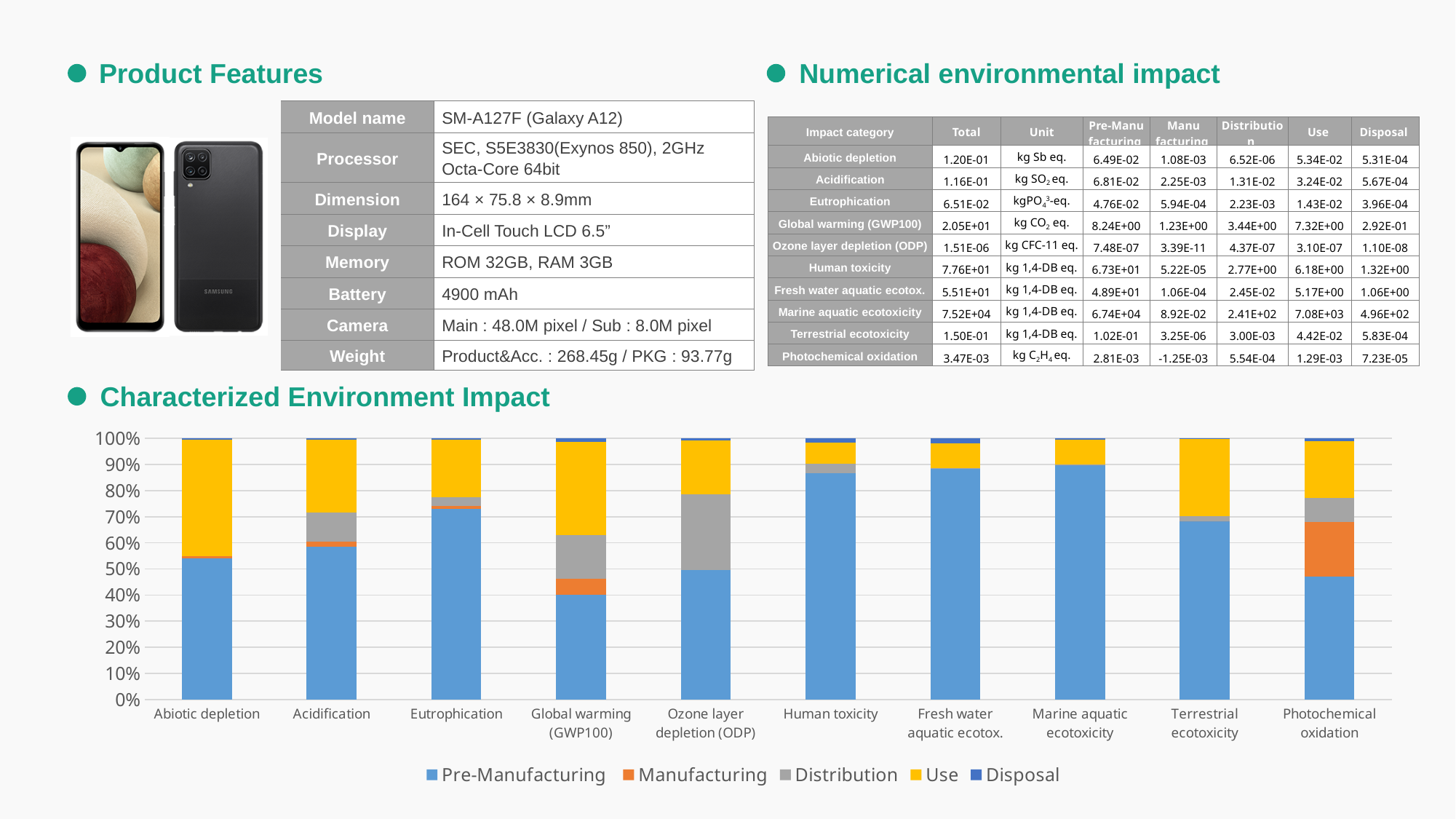
In the Characterized Environment Impact chart, which colour represents the Use series? yellow What kind of chart is shown under 'Characterized Environment Impact'? stacked bar chart In the Characterized Environment Impact chart, which impact category has the largest Distribution share? Ozone layer depletion (ODP) In the Characterized Environment Impact chart, which has the larger Pre-Manufacturing share: Acidification or Ozone layer depletion (ODP)? Acidification In the Characterized Environment Impact chart, which impact category has the largest Manufacturing share? Photochemical oxidation In the Characterized Environment Impact chart, is the Pre-Manufacturing share for Abiotic depletion greater or less than 50%? greater In the Characterized Environment Impact chart, is the Pre-Manufacturing share for Global warming (GWP100) greater or less than 50%? less In the Characterized Environment Impact chart, is the Pre-Manufacturing share for Human toxicity greater or less than 80%? greater In the Characterized Environment Impact chart, which impact category has the largest Pre-Manufacturing share? Marine aquatic ecotoxicity How many series does the legend of the Characterized Environment Impact chart list? 5 How many impact categories are plotted along the x axis of the Characterized Environment Impact chart? 10 In the Characterized Environment Impact chart, which impact category has the smallest Pre-Manufacturing share? Global warming (GWP100)